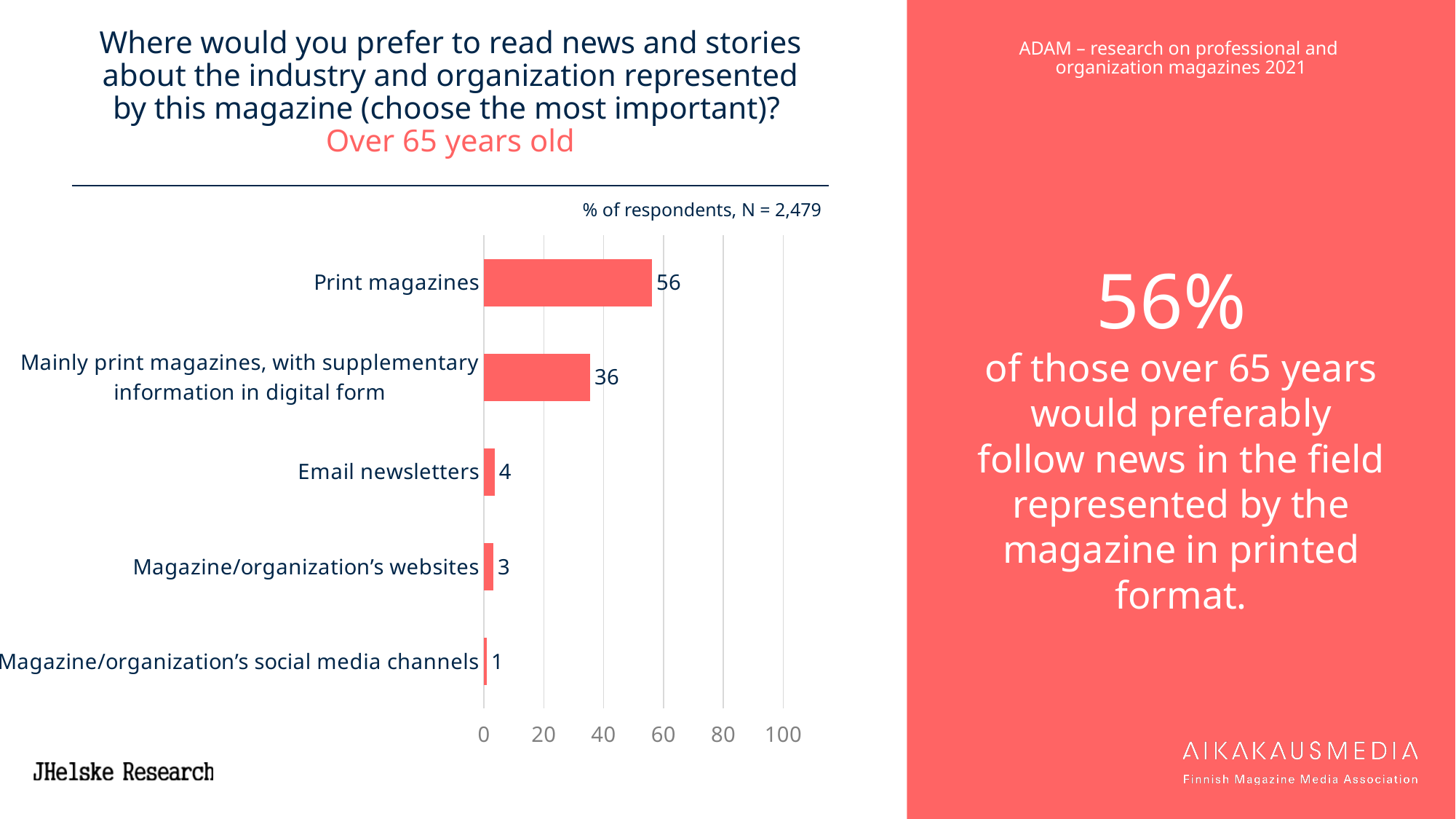
What is the value for 'Mainly print magazines, with supplementary information in digital form'? 36 Which category has the lowest value? Magazine/organization's social media channels How many categories are shown in the chart? 5 Which category has the highest value? Print magazines What is the difference between the values for Print magazines and Mainly print magazines, with supplementary information in digital form? 20 What is the value for Email newsletters? 4 Which is larger: the value for Email newsletters or the value for Magazine/organization's websites? Email newsletters What is the sample size (N) stated above the chart? 2,479 What percentage of respondents over 65 prefer print magazines? 56 What is the value for Magazine/organization's social media channels? 1 What kind of chart is shown on the slide? Bar chart Is the value for Print magazines greater or less than 40? greater